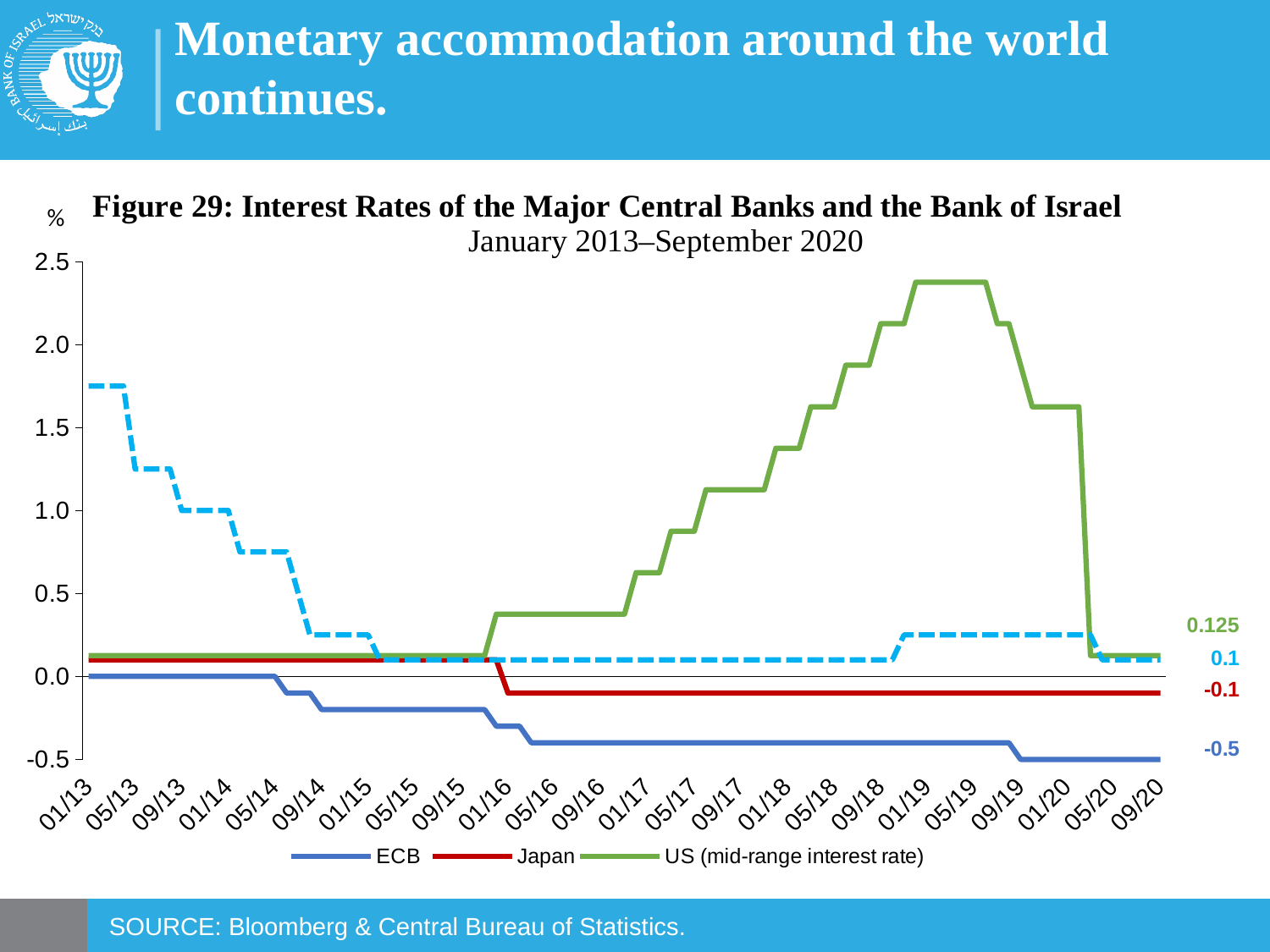
Which series has the highest value at the end of the period (09/20)? US (mid-range interest rate) What is the ECB interest rate at the end of the series (09/20)? -0.5 What kind of chart is shown on the slide? line chart What is the difference between the Japan rate and the ECB rate at the end of the period (09/20)? 0.4 What is the title of the chart? Figure 29: Interest Rates of the Major Central Banks and the Bank of Israel What is the Japan interest rate at the end of the series (09/20)? -0.1 What is the US (mid-range interest rate) value at the end of the series (09/20)? 0.125 How many series does the legend list? 3 Which series has the lowest value at the end of the period (09/20)? ECB At 09/20, which is larger, the ECB rate or the Japan rate? Japan Does the ECB series rise or fall over the period from 01/13 to 09/20? fall Is the peak value of the US (mid-range interest rate) series greater or less than 2.0? greater